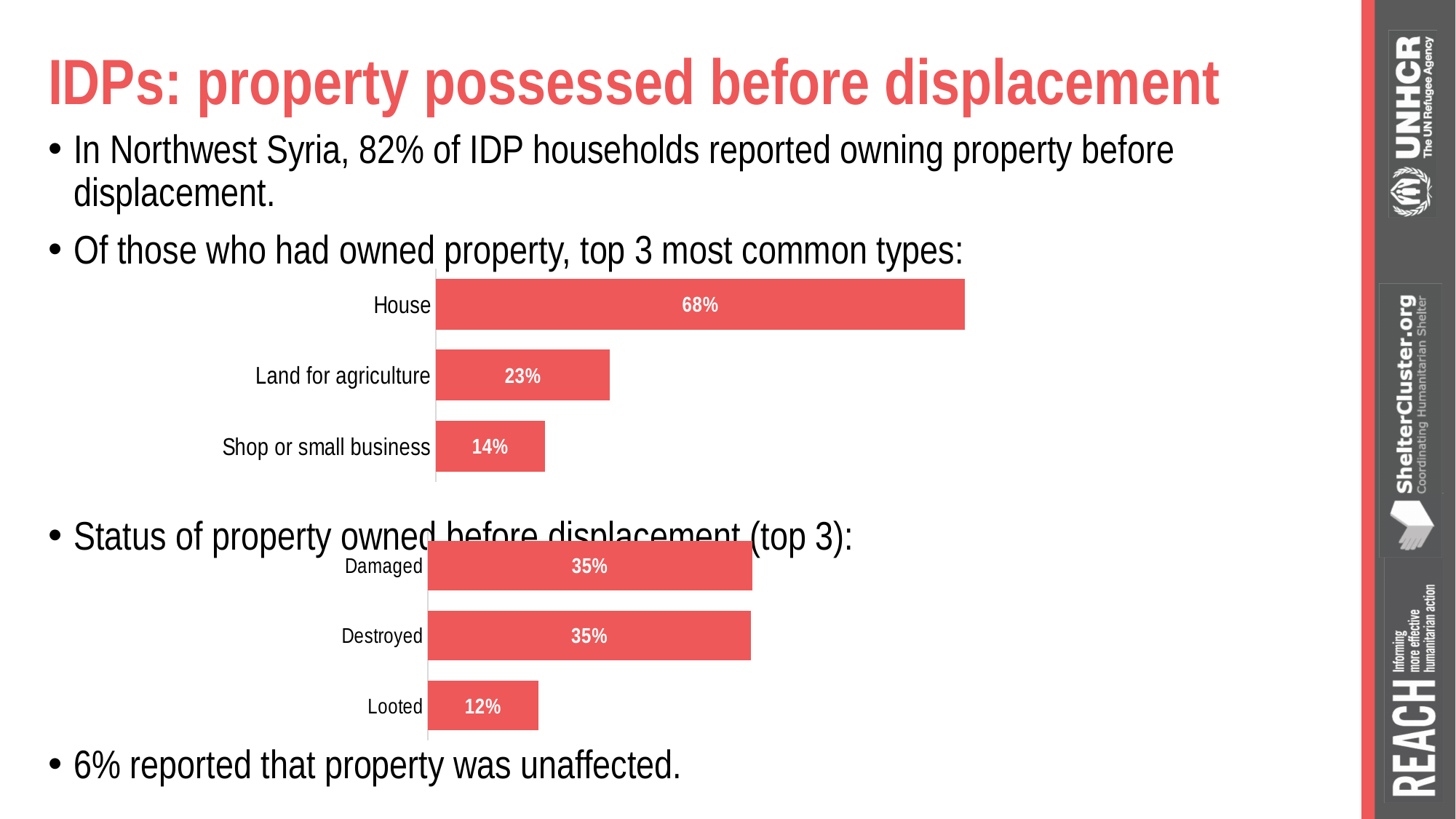
What type of chart is the upper chart (property types)? Bar chart In the upper chart (property types), what is the difference between the values for House and Land for agriculture? 45% In the upper chart (property types), what percentage is shown for Shop or small business? 14% In the lower chart (property status), what percentage is shown for Looted? 12% In the upper chart (property types), which category has the highest value? House In the lower chart (property status), what percentage is shown for Destroyed? 35% In the upper chart (property types), what percentage is shown for House? 68% In the lower chart (property status), what is the difference between the values for Damaged and Looted? 23% How many categories are shown in the lower chart (property status)? 3 In the lower chart (property status), which category has the lowest value? Looted In the upper chart (property types), which category has the lowest value? Shop or small business In the upper chart (property types), what percentage is shown for Land for agriculture? 23%